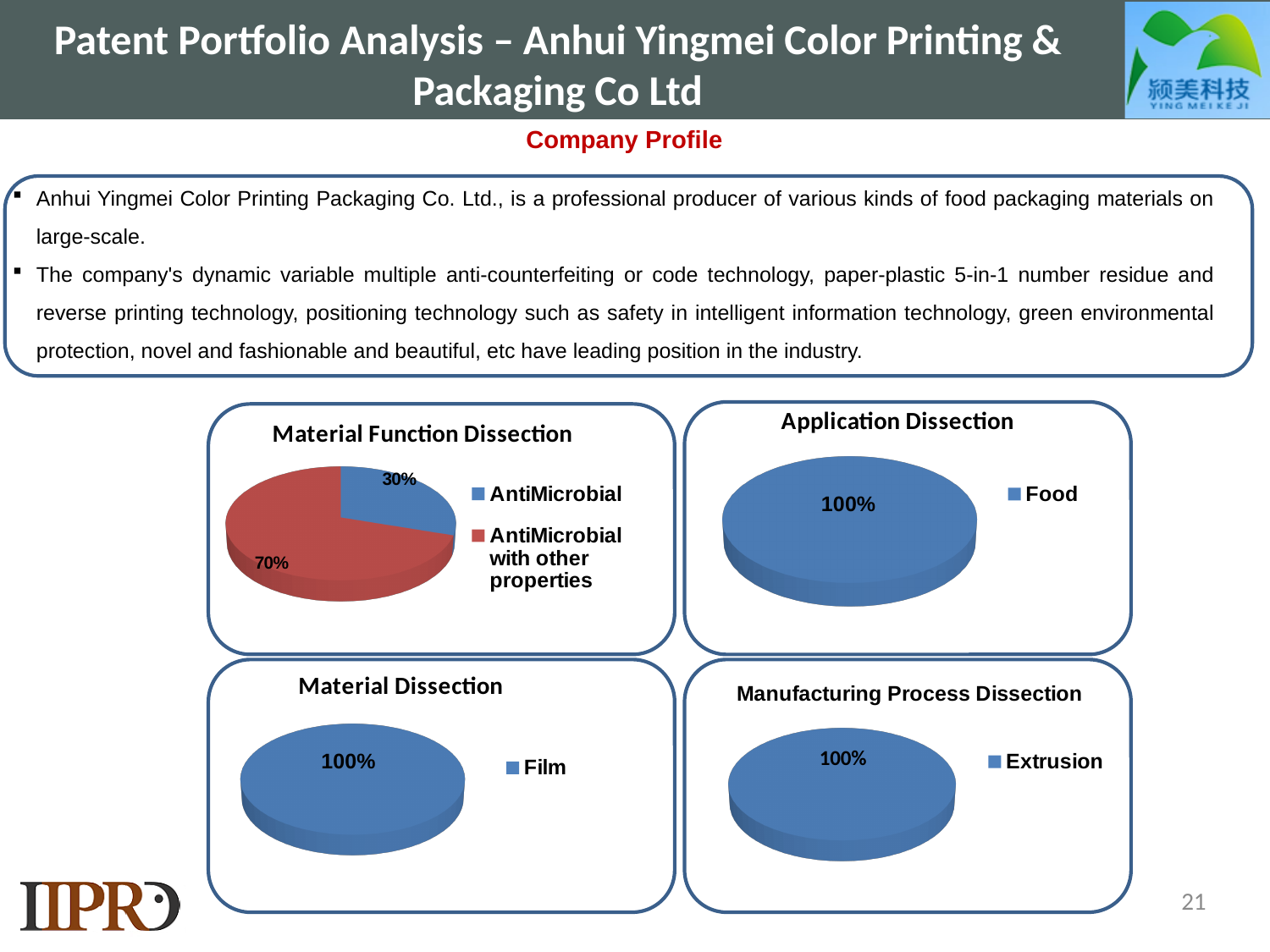
In the Material Function Dissection chart, what share does AntiMicrobial with other properties have? 70% In the Material Function Dissection chart, what share does AntiMicrobial have? 30% In the Material Function Dissection chart, which category has the largest share? AntiMicrobial with other properties In the Material Function Dissection chart, what is the difference between the shares of AntiMicrobial with other properties and AntiMicrobial? 40% In the Material Function Dissection chart, what colour is the AntiMicrobial slice? Blue In the Material Function Dissection chart, how many categories are shown? 2 In the Material Dissection chart, what share does Film have? 100% In the Application Dissection chart, what share does Food have? 100% In the Material Function Dissection chart, which category has the smallest share? AntiMicrobial What kind of chart is the Material Function Dissection chart? Pie chart In the Manufacturing Process Dissection chart, what share does Extrusion have? 100% In the Manufacturing Process Dissection chart, how many entries does the legend list? 1